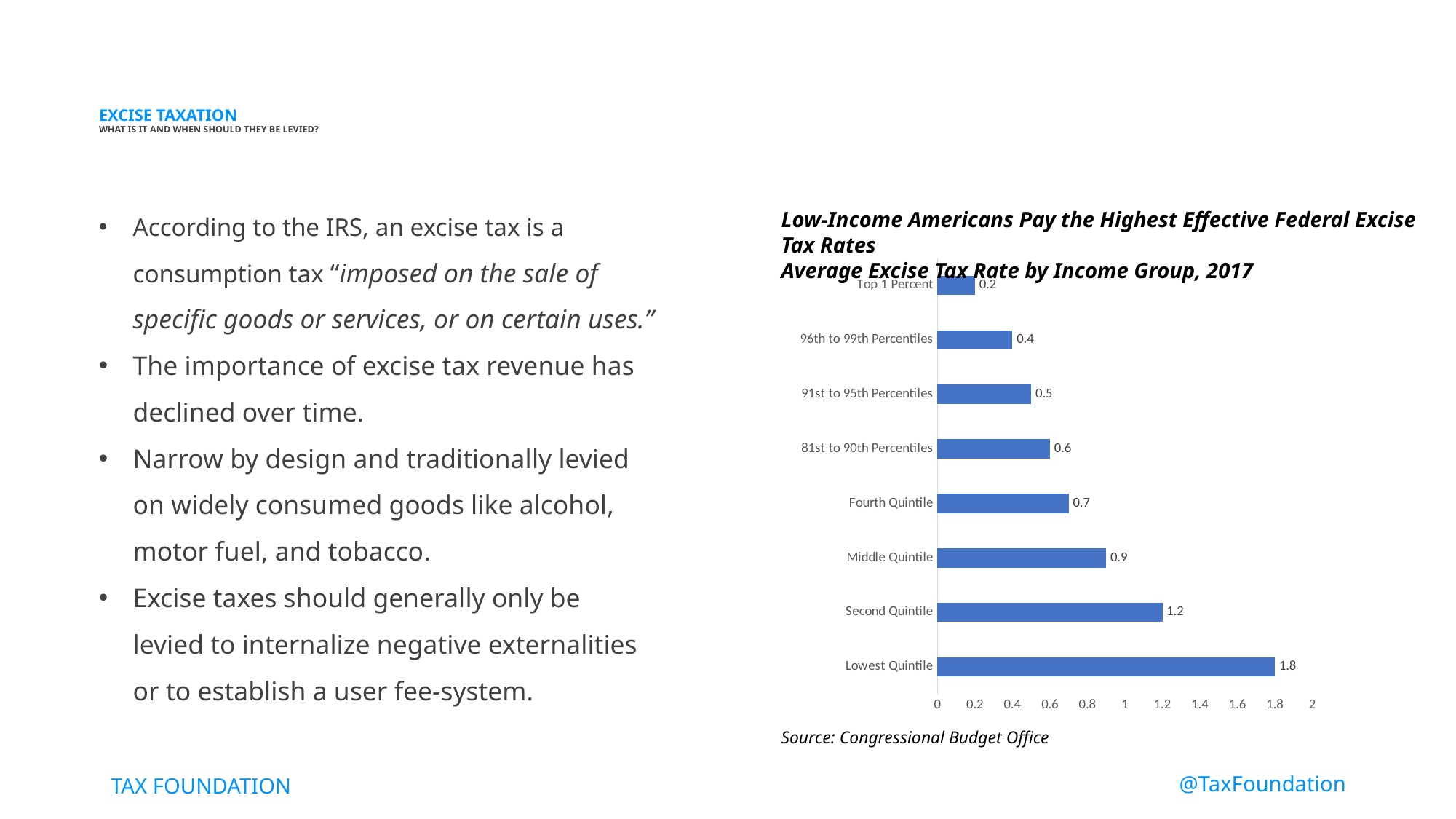
What is the average excise tax rate for the Top 1 Percent? 0.2 What is the value shown for the 81st to 90th Percentiles? 0.6 How many income groups are shown in the chart? 8 Which income group has the lowest average excise tax rate? Top 1 Percent Is the value for the Second Quintile greater or less than 1? greater Which income group has the highest average excise tax rate? Lowest Quintile What source is cited for the chart? Congressional Budget Office What is the average excise tax rate for the Middle Quintile? 0.9 What is the average excise tax rate for the Lowest Quintile? 1.8 Which has a higher average excise tax rate, the Fourth Quintile or the 96th to 99th Percentiles? Fourth Quintile What is the difference between the values for the Lowest Quintile and the Second Quintile? 0.6 What kind of chart is shown on the slide? Bar chart